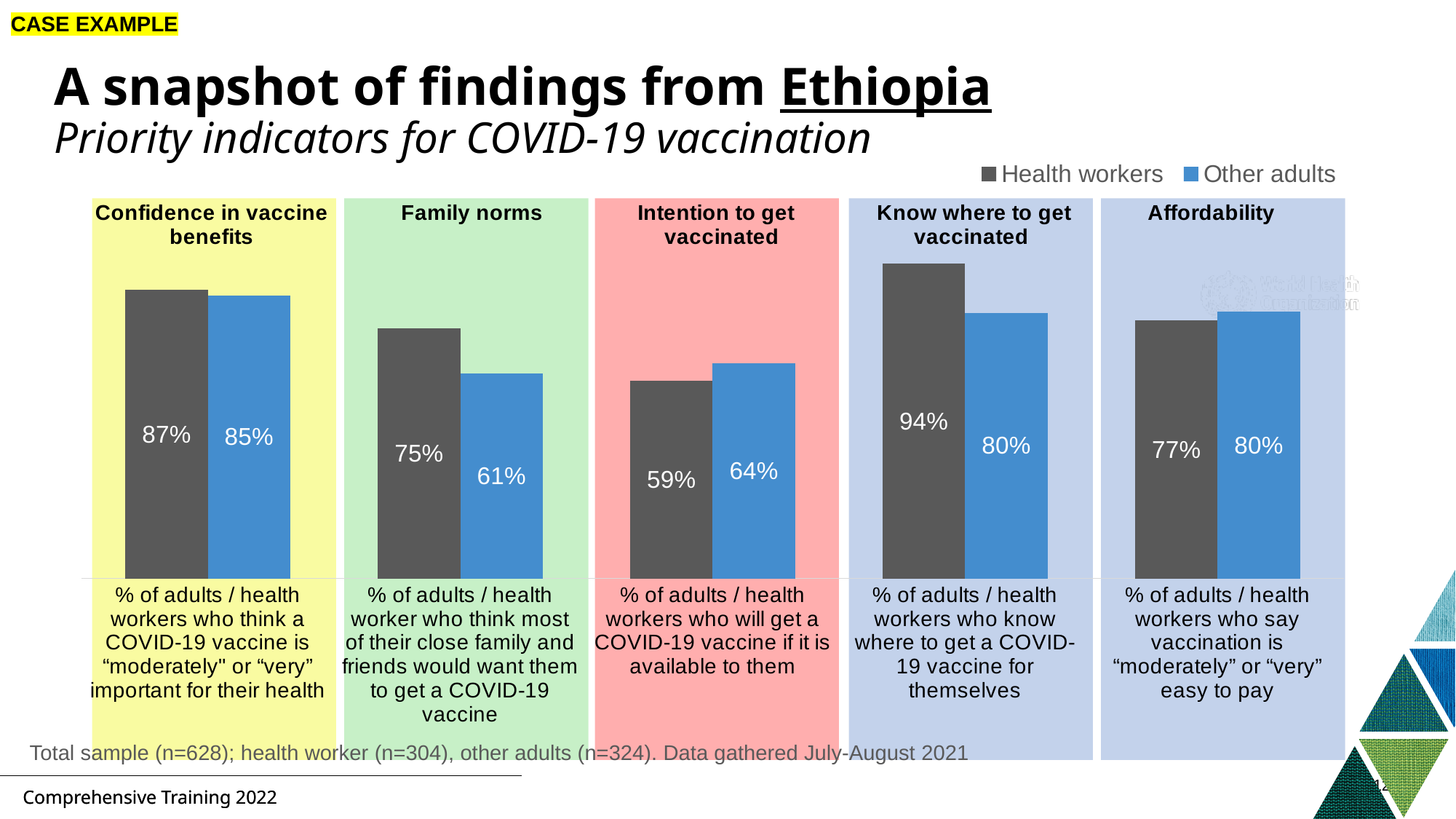
Which indicator has the lowest value for other adults? Family norms How many indicators are shown in the chart? 5 What percentage of health workers have confidence in vaccine benefits? 87% What is the value for health workers under Know where to get vaccinated? 94% What is the difference between health workers and other adults for Know where to get vaccinated? 14 percentage points For Affordability, which group has the larger value, health workers or other adults? Other adults What is the value for other adults under Family norms? 61% What percentage of other adults intend to get vaccinated? 64% Which indicator has the highest value for health workers? Know where to get vaccinated Which colour represents Other adults in the legend? Blue How many series does the legend list? 2 What kind of chart is shown on the slide? Bar chart